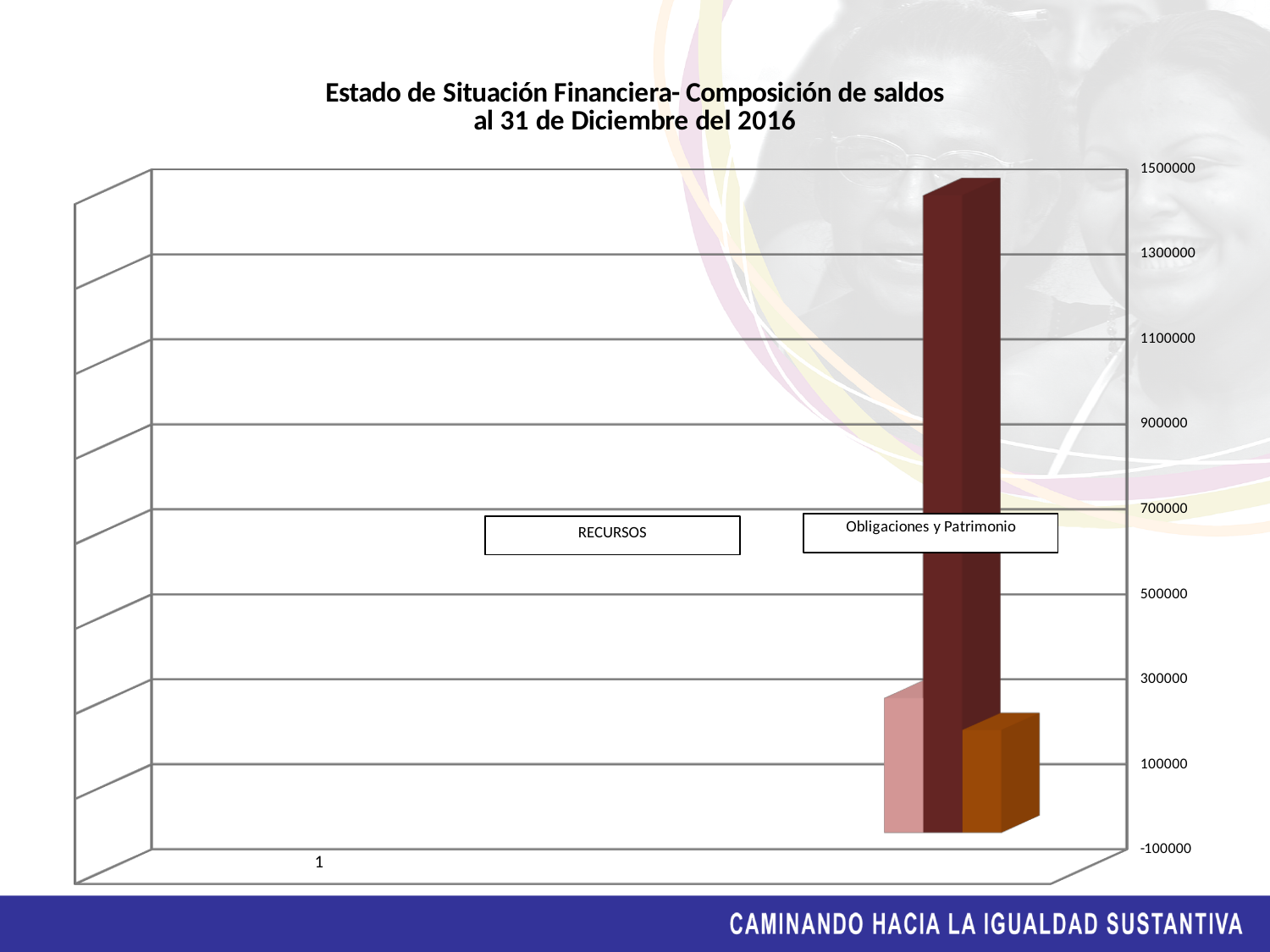
How many bars are plotted in the chart? 3 What label appears on the horizontal axis below the bars? 1 Is the value of the pink bar greater or less than 700000? less Is the value of the orange bar greater or less than 500000? less Which is larger, the pink bar or the dark red bar? the dark red bar What is the lowest value shown on the vertical axis? -100000 What kind of chart is shown on the slide? bar chart Which bar is the tallest in the chart? the dark red bar Is the value of the dark red bar greater or less than 1100000? greater What is the title of the chart? Estado de Situación Financiera- Composición de saldos al 31 de Diciembre del 2016 Which bar is the shortest in the chart? the orange bar